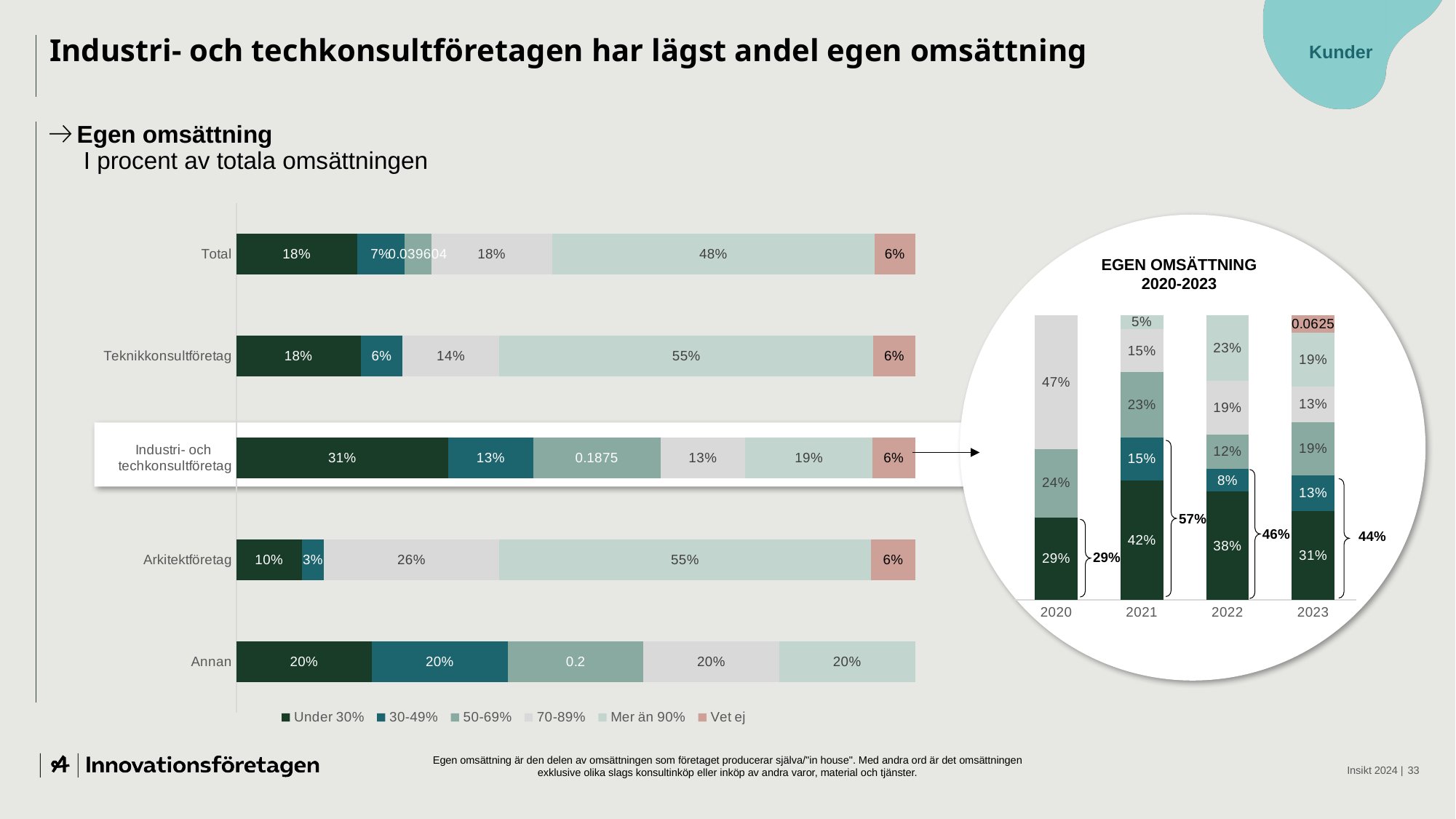
In the horizontal bar chart, what is the difference between the 'Mer än 90%' values for Teknikkonsultföretag and Industri- och techkonsultföretag? 36 percentage points How many series does the legend of the horizontal bar chart list? 6 In the horizontal bar chart, which has the larger '70-89%' segment: Total or Arkitektföretag? Arkitektföretag How many categories are shown in the horizontal bar chart? 5 In the 'EGEN OMSÄTTNING 2020-2023' chart, which year has the highest bottom (Under 30%) segment? 2021 In the 'EGEN OMSÄTTNING 2020-2023' chart, does the bottom (Under 30%) segment rise or fall from 2021 to 2023? Fall In the horizontal bar chart, what is the value of the 'Mer än 90%' segment for Arkitektföretag? 55% In the horizontal bar chart, which category has the lowest 'Under 30%' share? Arkitektföretag What type of chart is the main chart on the left of the slide? Bar chart In the horizontal bar chart, what is the value of the 'Under 30%' segment for Industri- och techkonsultföretag? 31% In the horizontal bar chart, which category has the highest 'Under 30%' share? Industri- och techkonsultföretag In the 'EGEN OMSÄTTNING 2020-2023' chart, what is the value of the bottom (Under 30%) segment for 2021? 42%